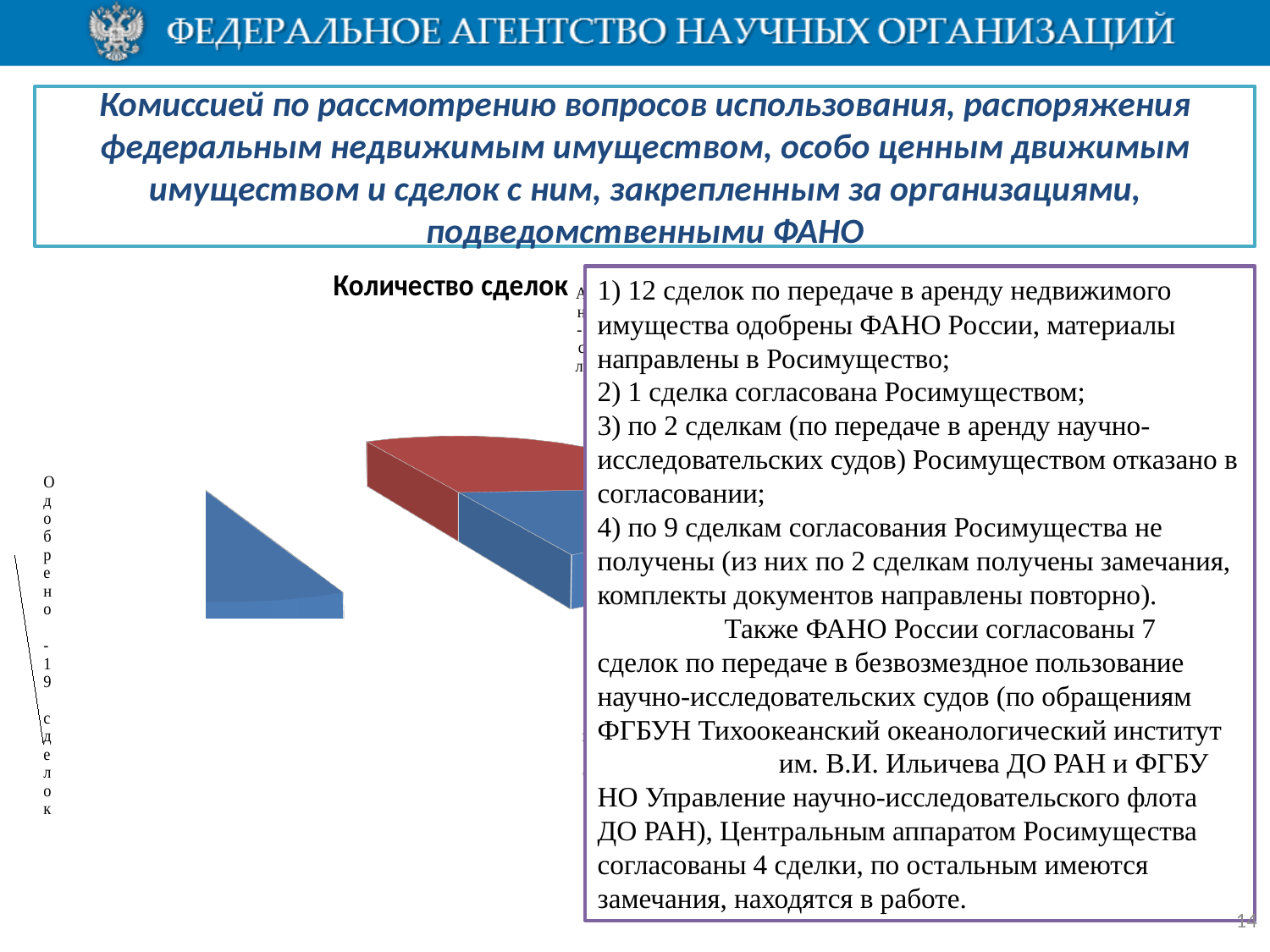
What is the title of the chart on the slide? Количество сделок What colour is the slice pulled out from the pie on the left side of the chart? blue How many deals does the chart label report as "Одобрено"? 19 What kind of chart is shown on the slide? pie chart